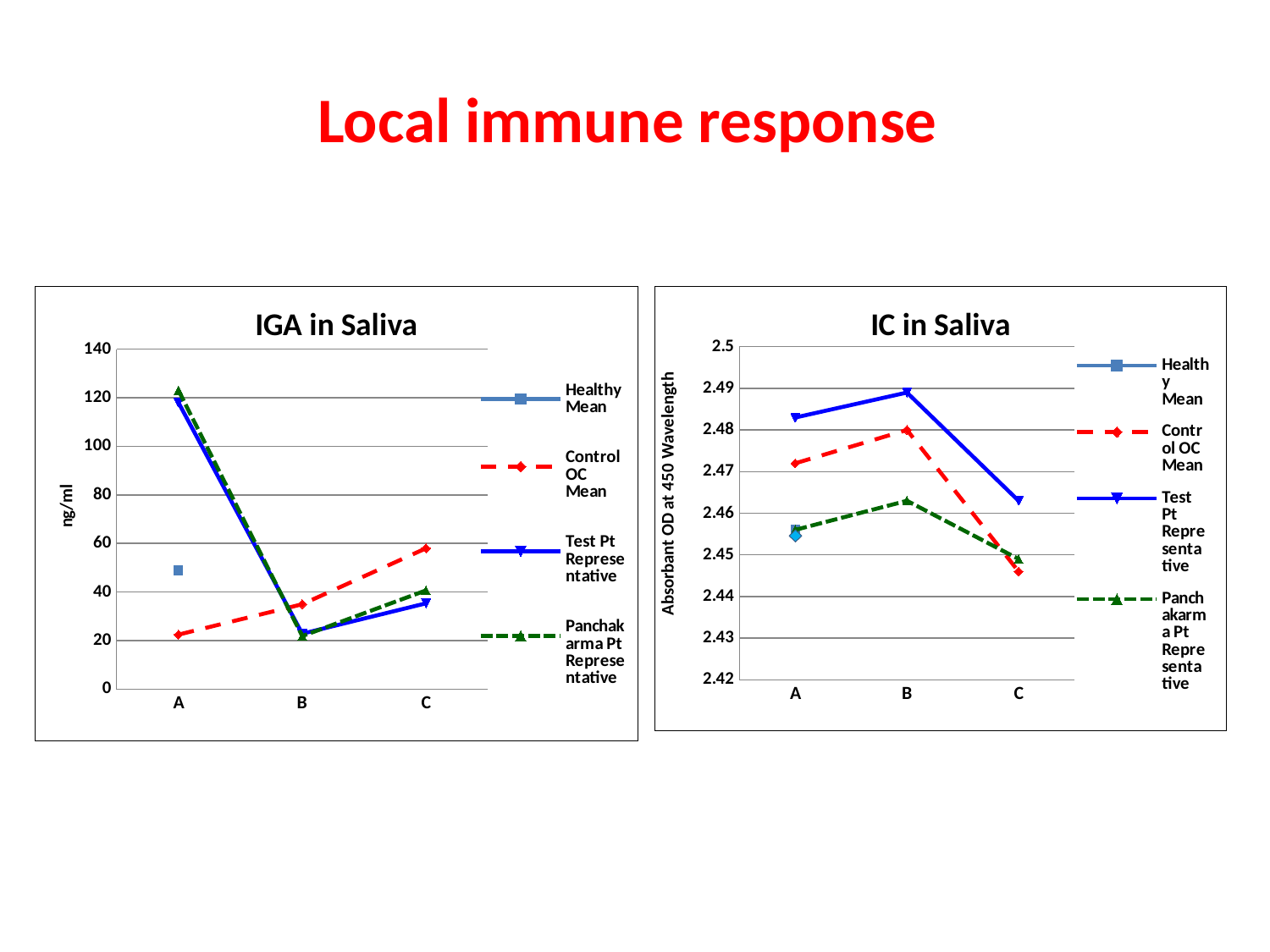
In the "IGA in Saliva" chart, is the value for Control OC Mean at A greater or less than 40? less What kind of chart is the "IGA in Saliva" chart? line chart How many categories are on the x axis of the "IGA in Saliva" chart? 3 How many series does the legend of the "IC in Saliva" chart list? 4 In the "IC in Saliva" chart, at which category is the Test Pt Representative series highest? B In the "IGA in Saliva" chart, is the value for Test Pt Representative at A greater or less than 100? greater In the "IGA in Saliva" chart, which is larger at C: Control OC Mean or Test Pt Representative? Control OC Mean What is the y-axis label of the "IGA in Saliva" chart? ng/ml In the "IGA in Saliva" chart, does the Control OC Mean series rise or fall from A to C? rise In the "IC in Saliva" chart, is the value for Test Pt Representative at B greater or less than 2.48? greater In the "IGA in Saliva" chart, at which category is the Control OC Mean series highest? C How many series does the legend of the "IGA in Saliva" chart list? 4